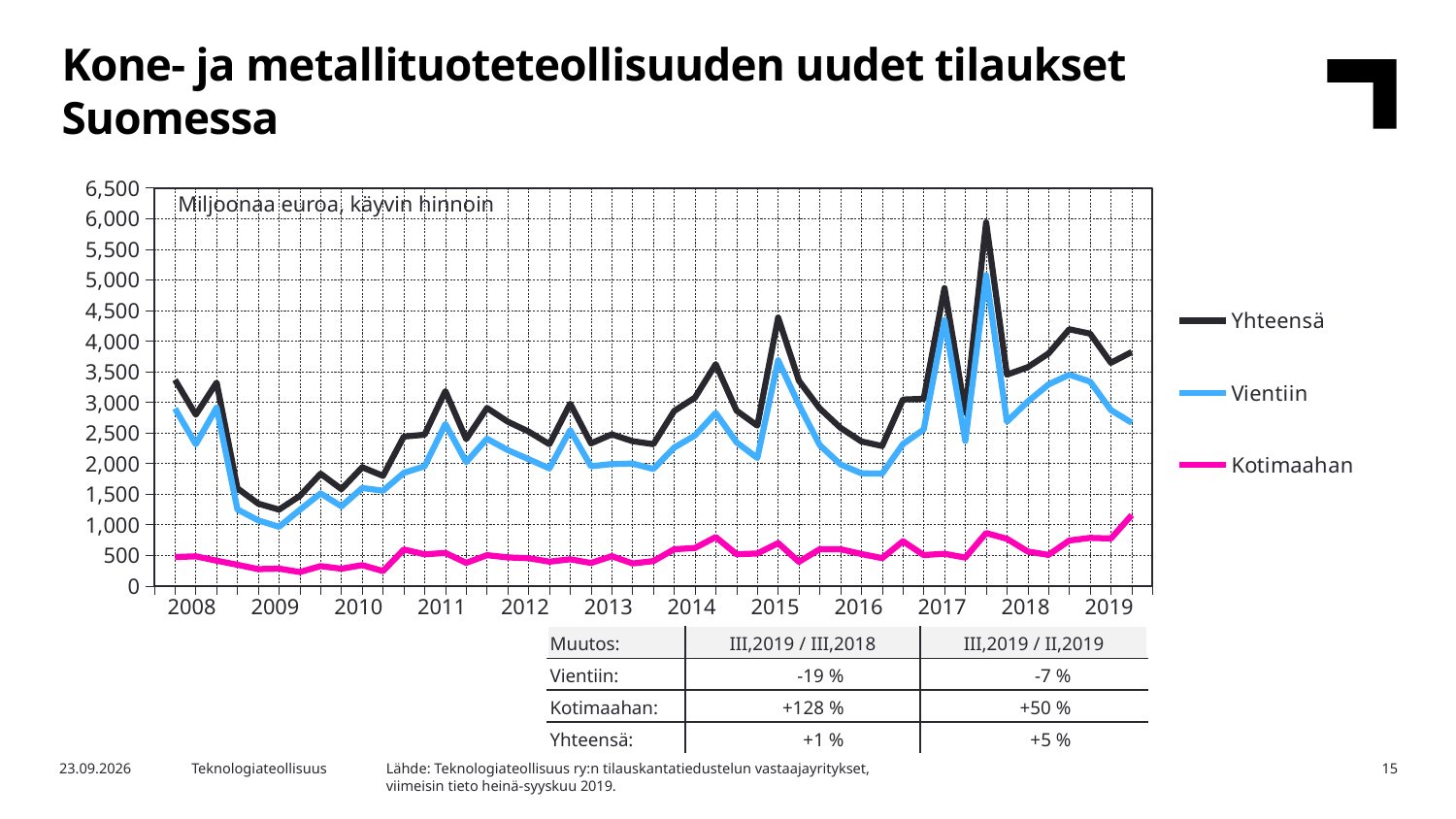
What are the three series named in the chart legend? Yhteensä, Vientiin, Kotimaahan Does the Kotimaahan line ever rise above 1,500 on the chart? no Does the Yhteensä line rise or fall between 2008 and 2009? fall Which series has the highest values throughout the chart? Yhteensä How many years are labelled on the x axis of the chart? 12 Is the highest peak of the Vientiin line greater or less than 4,500? greater Is the Vientiin value at its lowest point in 2009 greater or less than 1,500? less What unit label is printed inside the chart area? Miljoonaa euroa, käyvin hinnoin What kind of chart is shown on the slide? line chart How many series does the chart legend list? 3 Which series has the lowest values throughout the chart? Kotimaahan